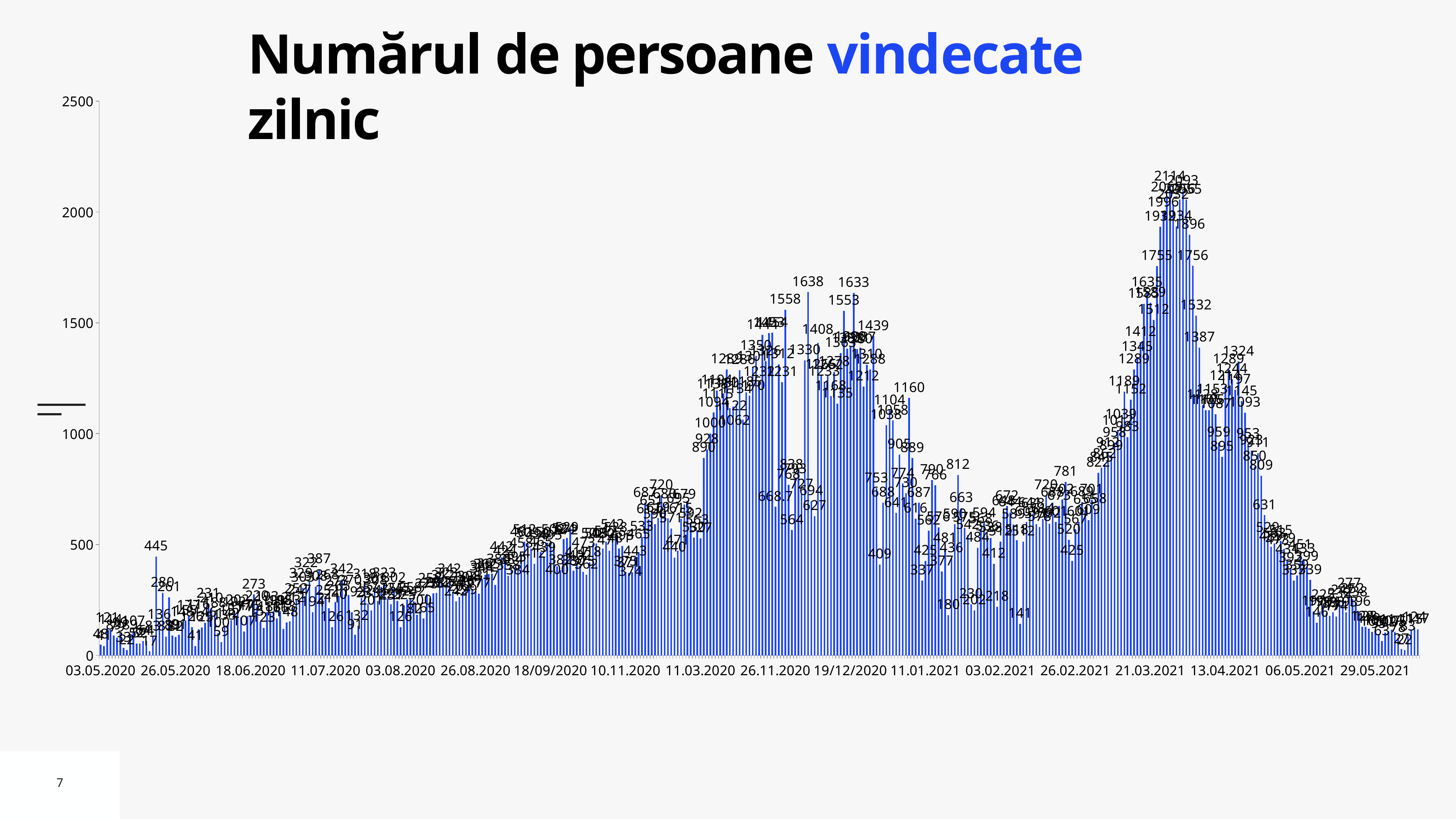
What is the value of the tallest bar near 26.05.2020? 445 What is the highest value labelled on the chart? 2114 Do the values rise or fall along the x axis from 21.03.2021 to 29.05.2021? fall What is the value of the tallest bar in the peak between 26.11.2020 and 19/12/2020? 1638 What is the title of the chart? Numărul de persoane vindecate zilnic What is the highest tick value shown on the vertical axis? 2500 What is the difference between the highest bar of the chart (2114) and the highest bar of the late-2020 peak (1638)? 476 Which peak is higher: the one around 26.11.2020–19/12/2020 or the one around 21.03.2021? the one around 21.03.2021 Are the bars near 29.05.2021 greater or less than 500? less What is the first date label on the x axis? 03.05.2020 Is the tallest bar on the chart greater or less than 2000? greater What kind of chart is shown on the slide? bar chart